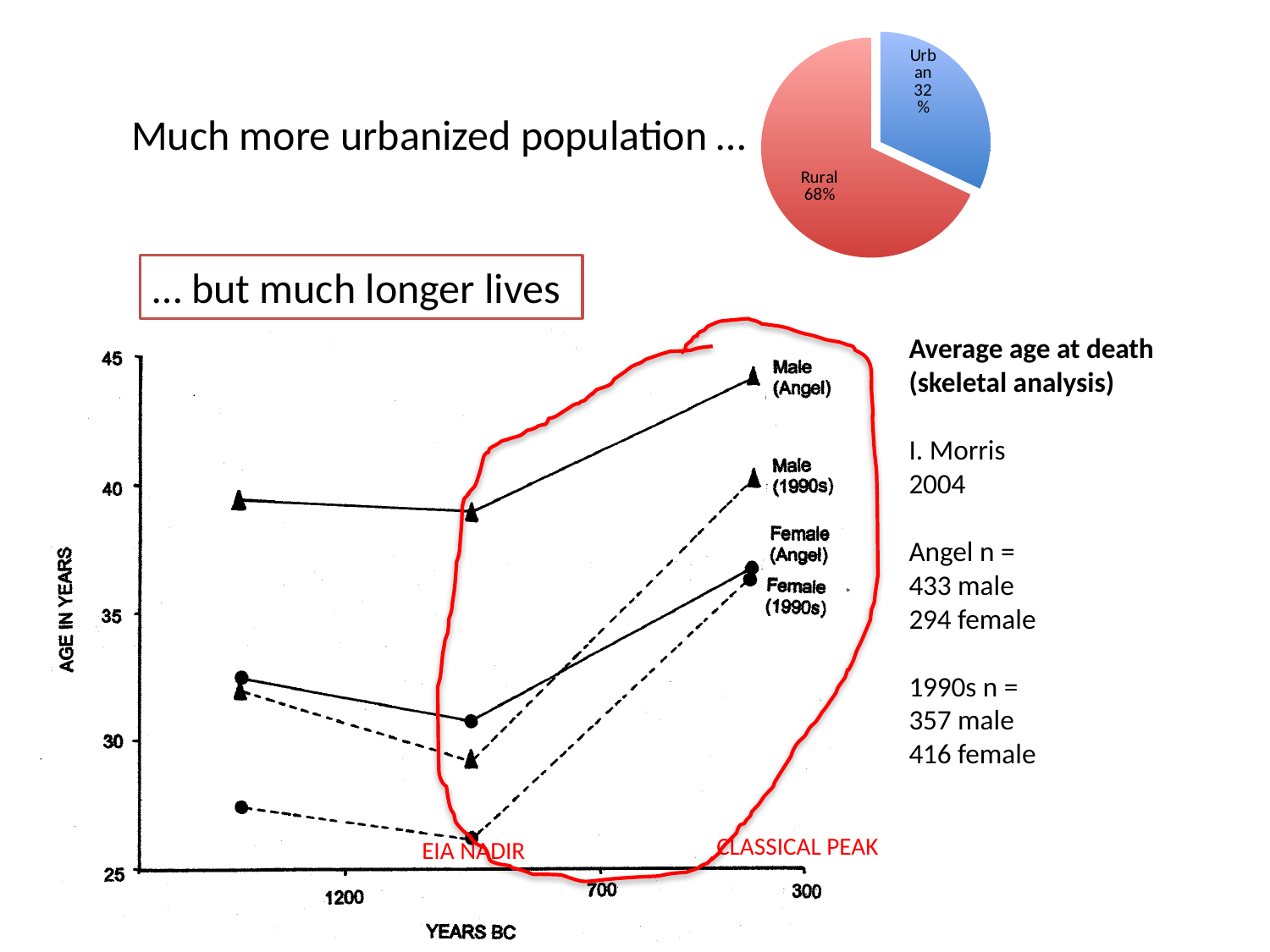
In the 'Average age at death' line chart, is the Male (Angel) value at the Classical Peak (around 300 BC) greater or less than 40? greater In the pie chart, which slice is larger, Rural or Urban? Rural In the pie chart, how many slices are there? 2 In the pie chart, what percentage of the population is Rural? 68% In the pie chart, what is the difference in percentage points between the Rural and Urban shares? 36 percentage points In the pie chart, what percentage of the population is Urban? 32% What kind of chart is the chart at the top right of the slide? Pie chart In the 'Average age at death' line chart, how many series are plotted? 4 In the 'Average age at death' line chart, which series has the lowest value at the EIA Nadir (around 1000 BC)? Female (1990s) In the 'Average age at death' line chart, which series has the highest value at the Classical Peak (around 300 BC)? Male (Angel) What kind of chart is the 'Average age at death' chart at the bottom of the slide? Line chart In the 'Average age at death' line chart, what is the label of the vertical axis? AGE IN YEARS